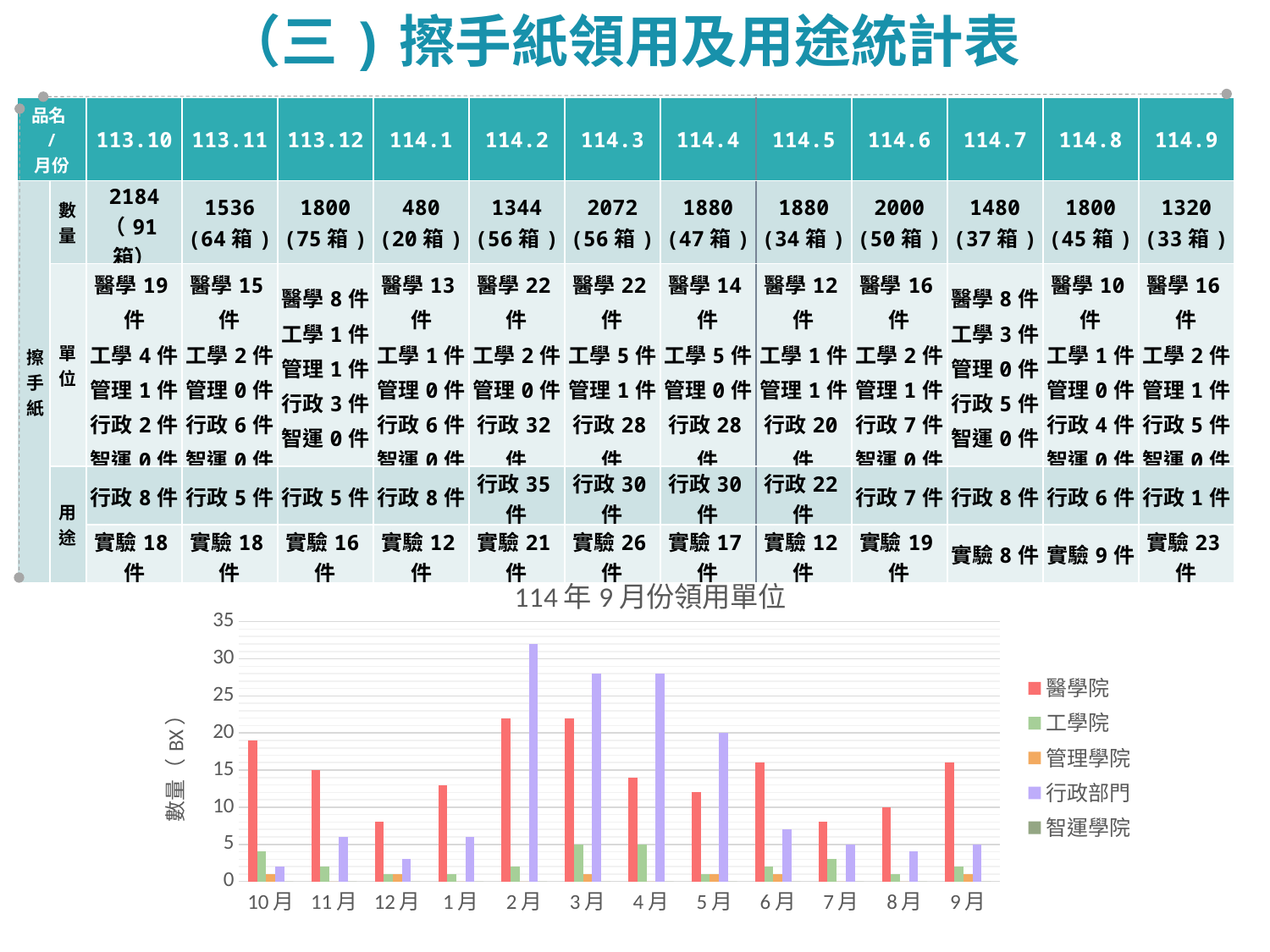
Is the value for 醫學院 in 10月 greater or less than 15? greater How many series does the legend of the chart list? 5 In which month is the 行政部門 bar the highest? 2月 How many months are shown on the x axis of the chart? 12 In 6月, which is larger: the 醫學院 bar or the 行政部門 bar? 醫學院 What is the value of 醫學院 in 11月? 15 What is the title of the chart? 114年9月份領用單位 In 3月, which is larger: the 醫學院 bar or the 行政部門 bar? 行政部門 Is the value for 行政部門 in 2月 greater or less than 30? greater What is the value of 行政部門 in 5月? 20 What is the value of 醫學院 in 8月? 10 What kind of chart is shown below the table? bar chart